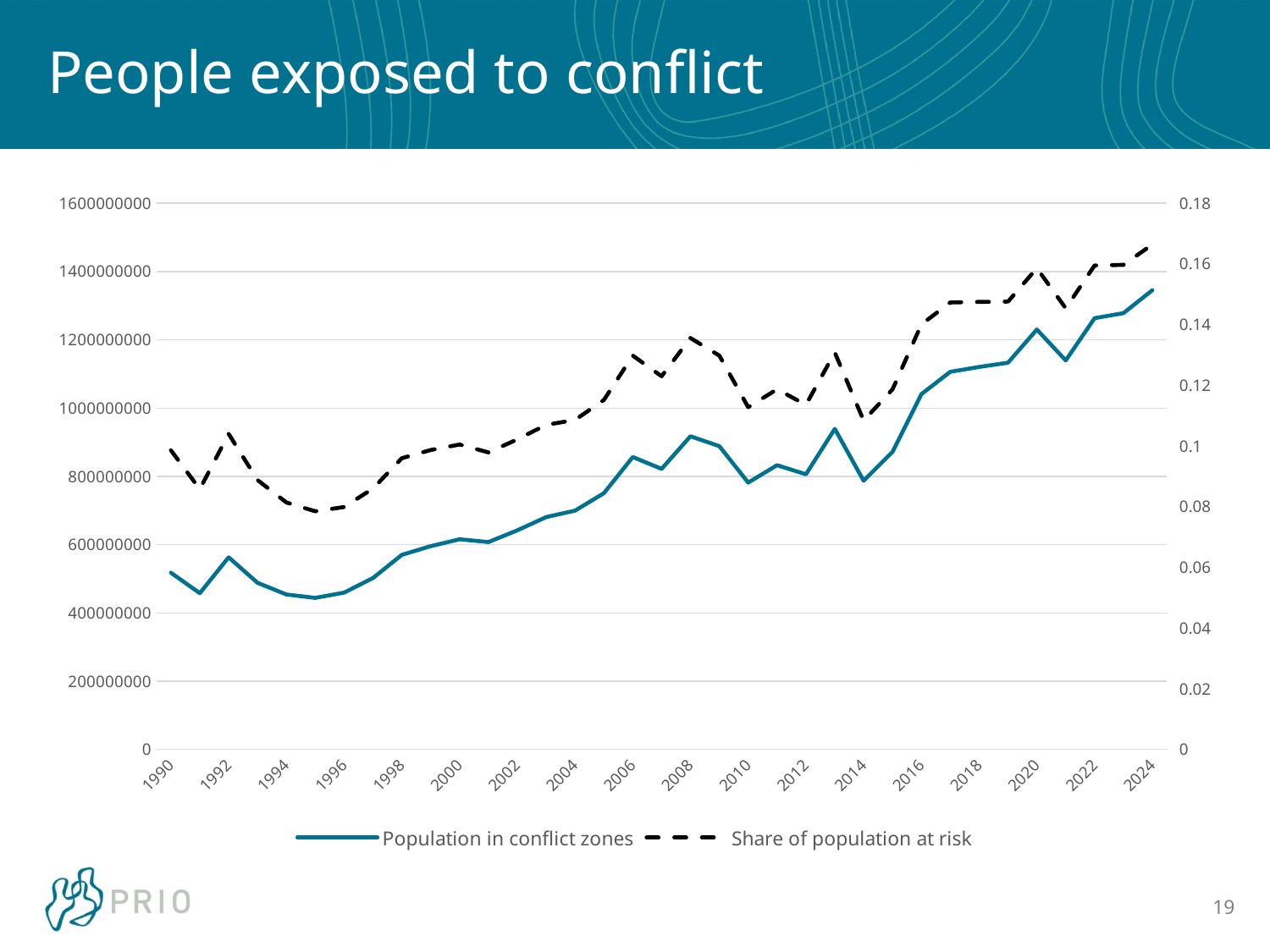
Which series is drawn with a dashed line? Share of population at risk Is the value for Population in conflict zones in 2008 greater or less than 800000000? greater Which is larger for Share of population at risk: the value in 2008 or the value in 2010? 2008 What kind of chart is shown on the slide? line chart Is the value for Population in conflict zones in 2024 greater or less than 1200000000? greater In which year does Share of population at risk reach its highest value? 2024 Overall, does the Population in conflict zones line rise or fall from 1990 to 2024? rise In which year does Population in conflict zones reach its highest value? 2024 What is the title of the slide containing the chart? People exposed to conflict How many series does the legend list? 2 Is the value for Share of population at risk in 1995 greater or less than 0.1? less